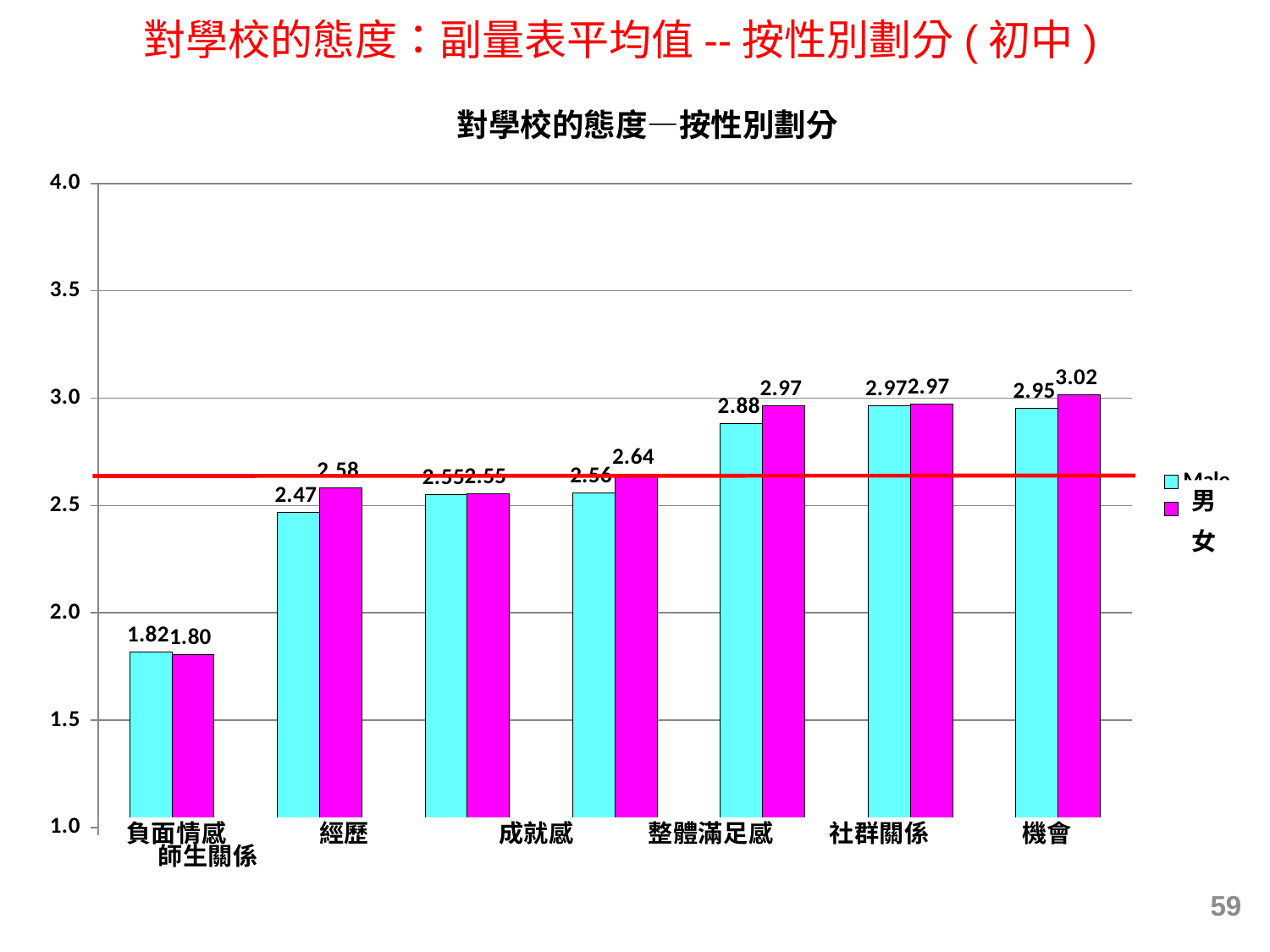
What is the difference between the 女 and 男 values in the 經歷 category? 0.11 How many series does the chart plot? 2 What kind of chart is shown on the slide? bar chart How many categories are shown on the x axis? 7 Is the value for 男 in the 社群關係 category greater or less than 2.5? greater What is the value for 女 in the 經歷 category? 2.58